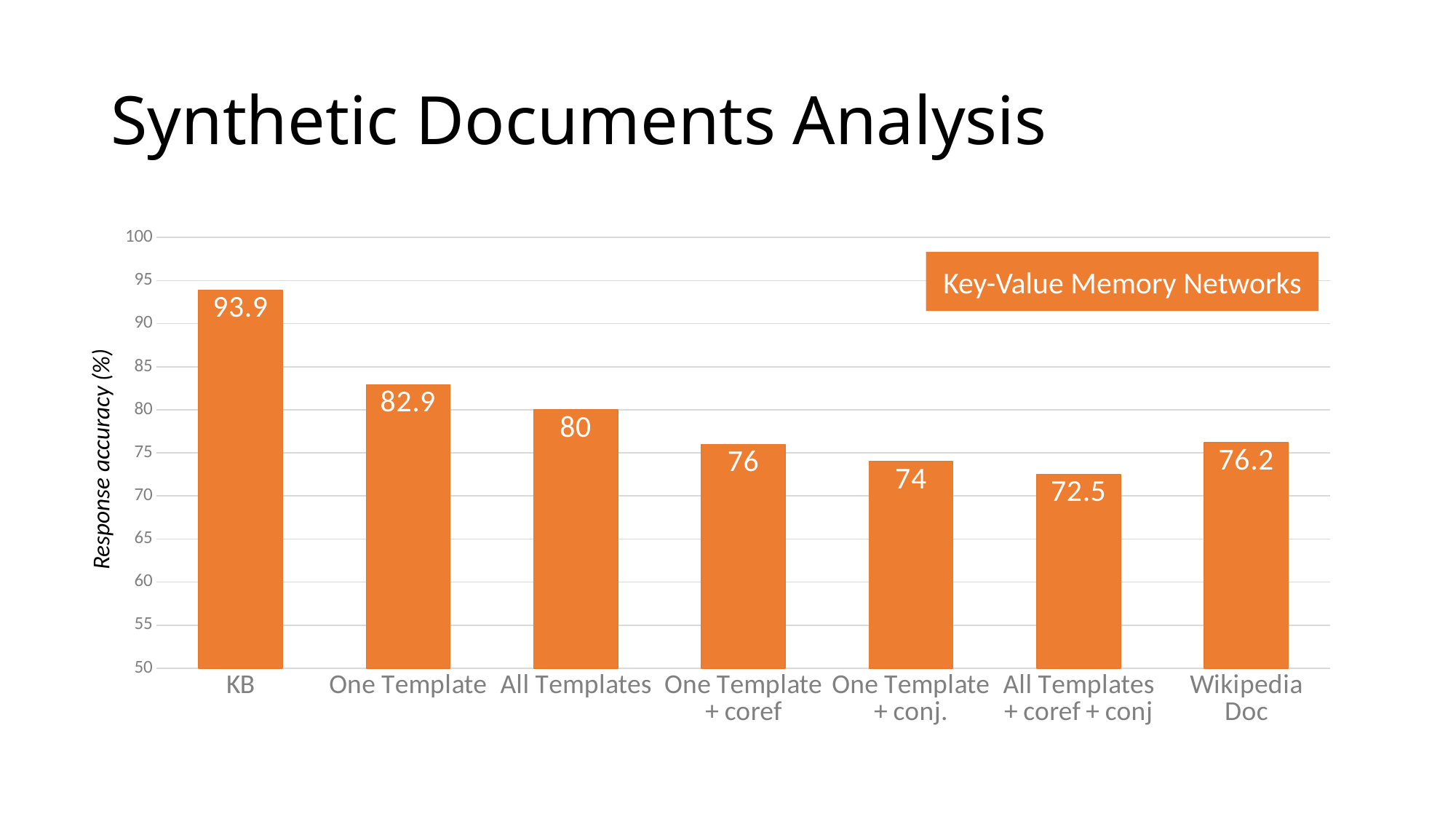
Which category has the highest response accuracy? KB How many categories are shown on the x axis? 7 Is the value for One Template greater or less than 80? greater What is the difference in response accuracy between KB and One Template? 11 What is the response accuracy for One Template + coref? 76 Which category has the lowest response accuracy? All Templates + coref + conj What is the response accuracy for Wikipedia Doc? 76.2 What is the label of the y axis? Response accuracy (%) Which has a higher response accuracy, One Template + conj. or Wikipedia Doc? Wikipedia Doc What kind of chart is shown on the slide? Bar chart What is the response accuracy for KB? 93.9 What is the difference in response accuracy between All Templates and All Templates + coref + conj? 7.5